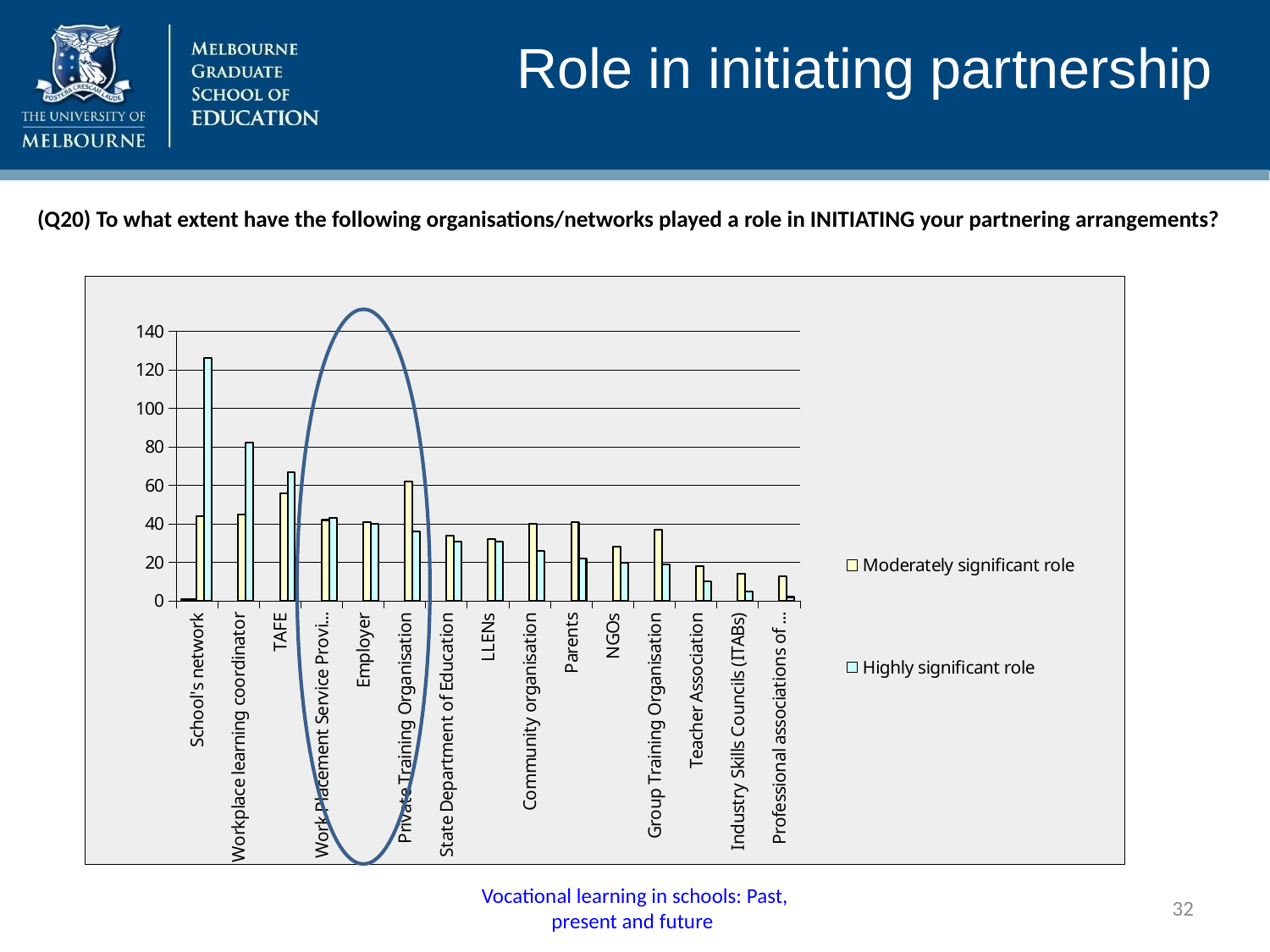
What kind of chart is shown on the slide? bar chart Which is larger: the 'Highly significant role' value for School's network or for Workplace learning coordinator? School's network Is the 'Moderately significant role' value for Industry Skills Councils (ITABs) greater or less than 20? less Is the 'Moderately significant role' value for Private Training Organisation greater or less than 40? greater How many series does the chart legend list? 2 How many organisation/network categories are shown on the x axis of the chart? 15 What are the two legend entries of the chart? Moderately significant role; Highly significant role Is the 'Highly significant role' value for Workplace learning coordinator greater or less than 60? greater Do the 'Highly significant role' values generally rise or fall moving from left to right along the x axis? fall Which is larger: the 'Highly significant role' value for TAFE or for Employer? TAFE Which category has the highest value for the 'Highly significant role' series? School's network